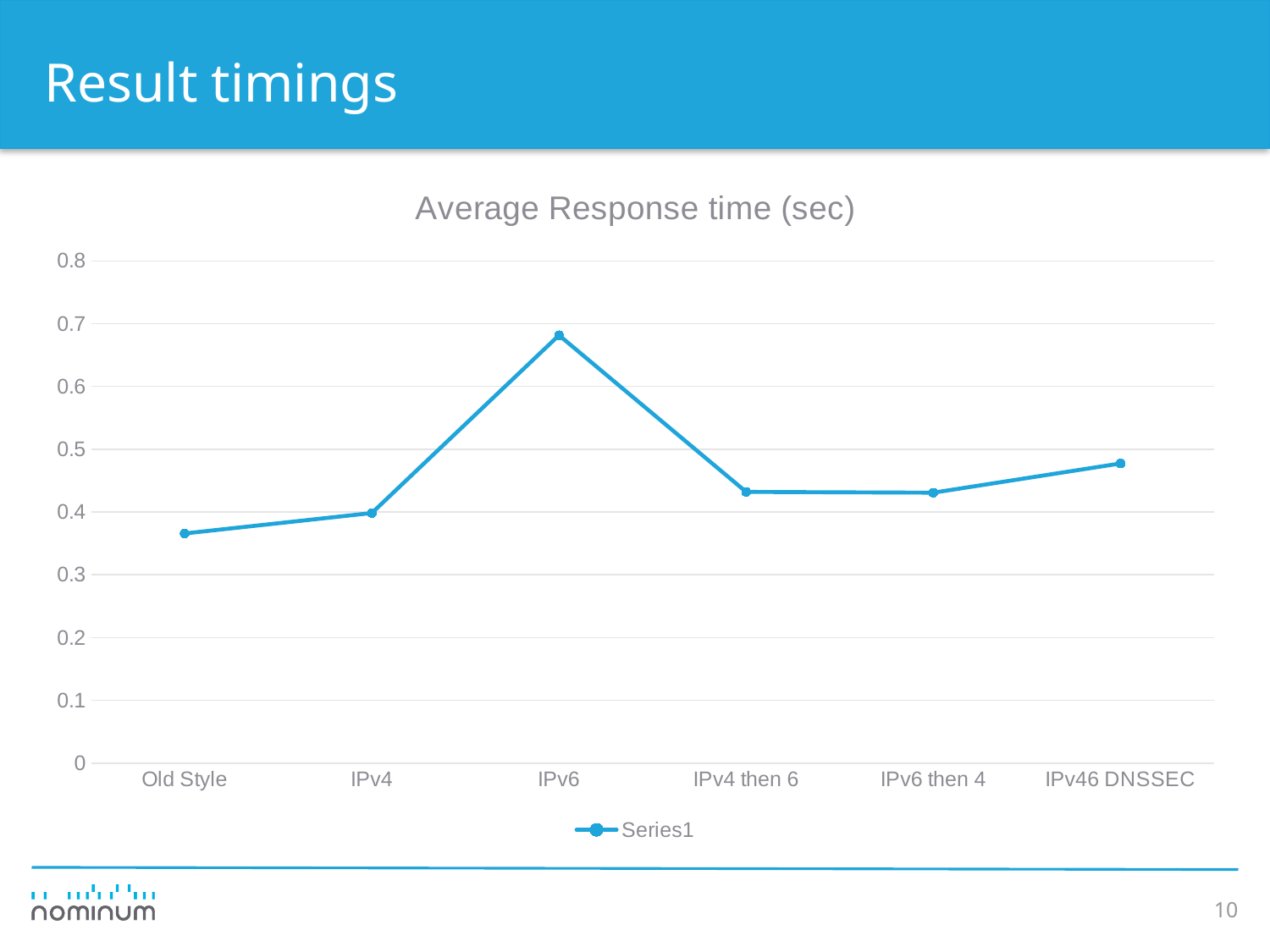
What kind of chart is shown on the slide? line chart What is the title of the chart? Average Response time (sec) Is the value for IPv46 DNSSEC greater or less than 0.5? less Which category has the highest average response time? IPv6 Is the value for IPv6 greater or less than 0.6? greater What is the name of the series shown in the legend? Series1 Which category has the lowest average response time? Old Style Do the values rise or fall from Old Style to IPv6? rise Which has a higher average response time, IPv6 or IPv46 DNSSEC? IPv6 How many categories are plotted along the x axis? 6 How many series does the legend list? 1 Is the value for Old Style greater or less than 0.4? less